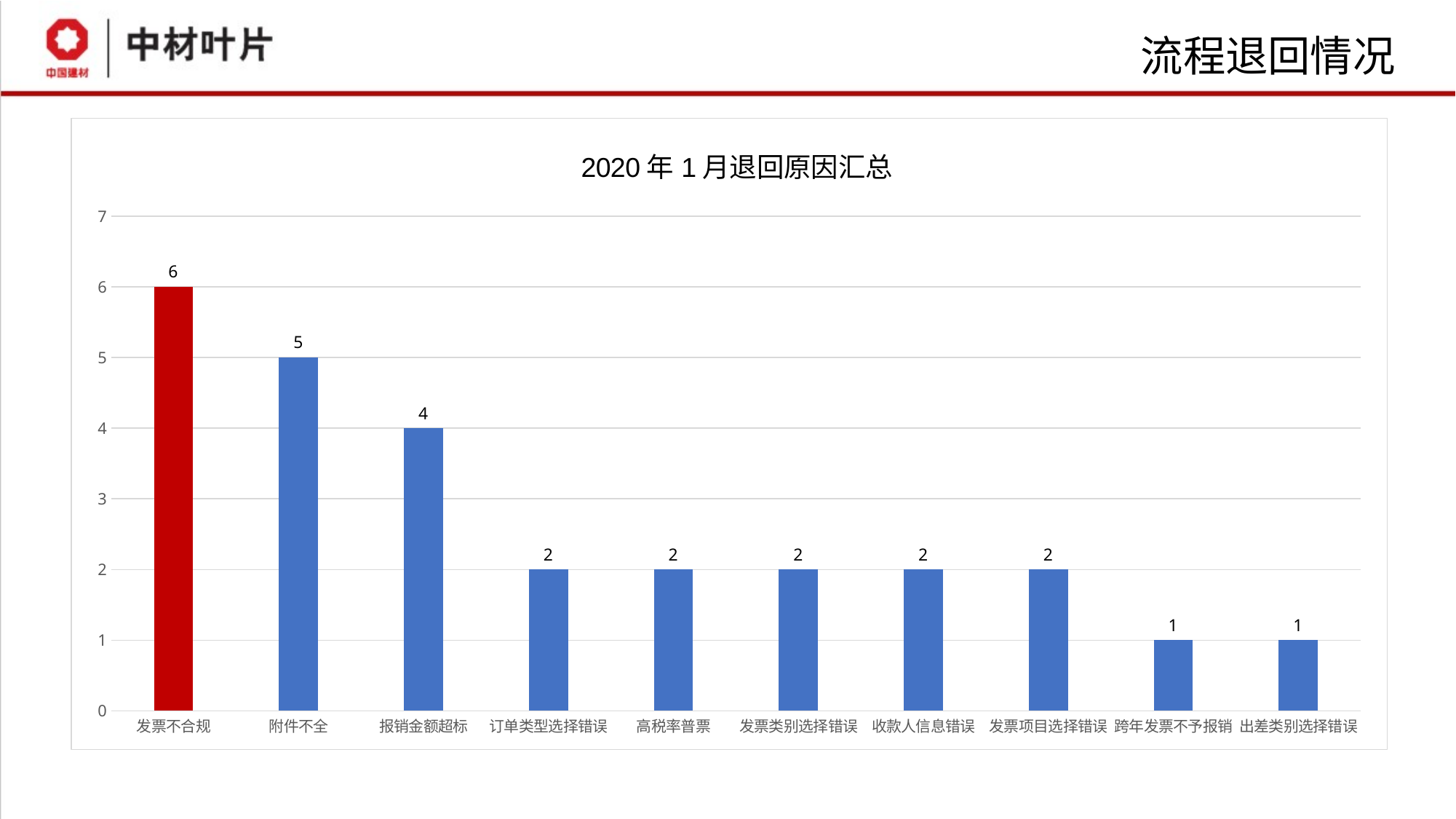
What is the title of the chart? 2020年1月退回原因汇总 Which bar is coloured red rather than blue? 发票不合规 What kind of chart is shown on the slide? bar chart What is the value for 发票不合规? 6 What is the value for 跨年发票不予报销? 1 What is the difference between the values for 报销金额超标 and 出差类别选择错误? 3 Which is larger, the value for 附件不全 or the value for 高税率普票? 附件不全 What is the value for 附件不全? 5 What is the value for 报销金额超标? 4 What is the difference between the values for 发票不合规 and 附件不全? 1 How many categories are shown on the x axis? 10 Which category has the highest value? 发票不合规